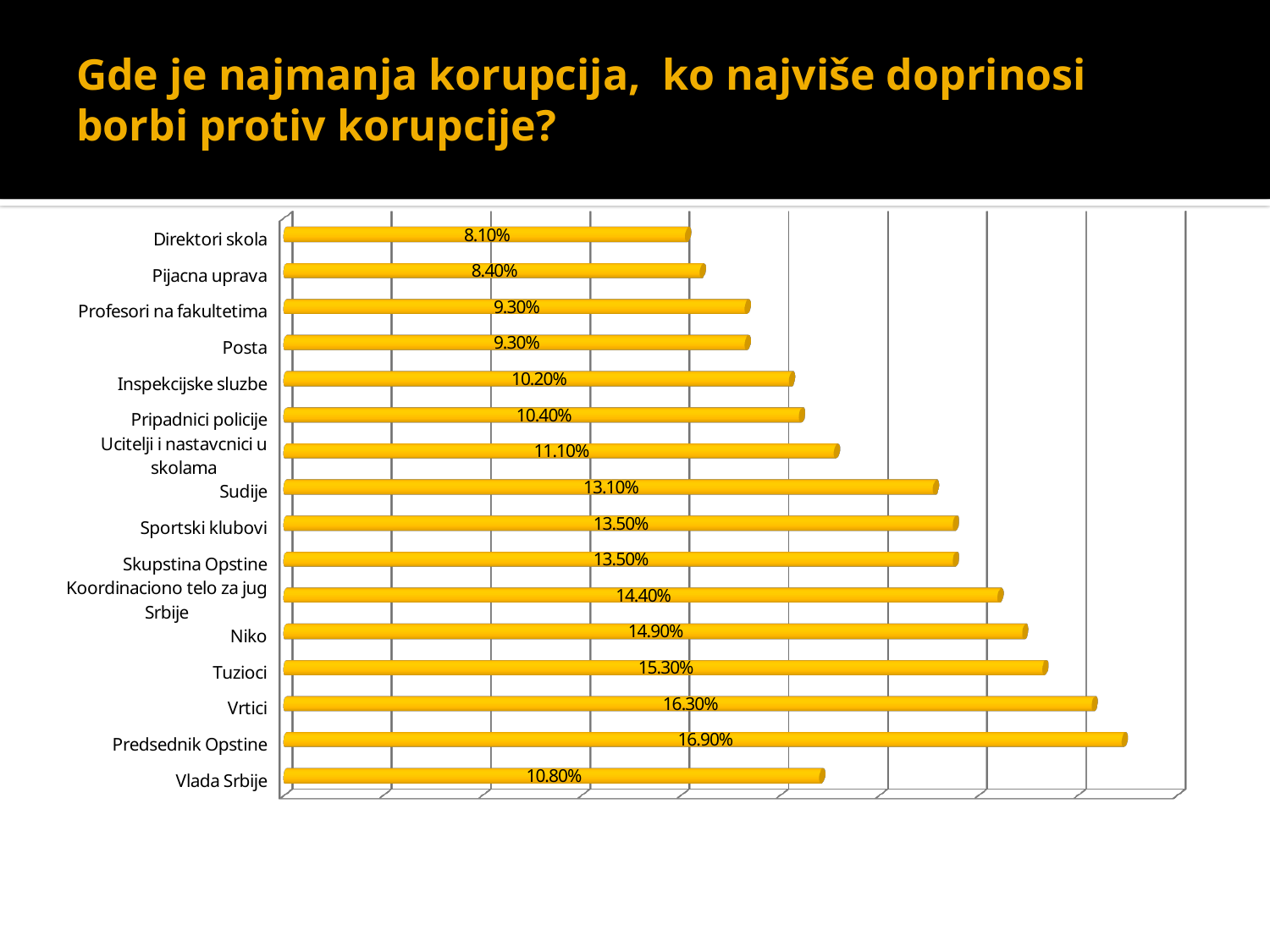
What is the difference between the values for Vrtici and Tuzioci? 1.00% What is the value for Sudije? 13.10% What is the value for Pripadnici policije? 10.40% What is the value for Vlada Srbije? 10.80% What is the value for Predsednik Opstine? 16.90% What is the title of the slide? Gde je najmanja korupcija, ko najviše doprinosi borbi protiv korupcije? What kind of chart is shown on the slide? Bar chart Which has a larger value, Niko or Koordinaciono telo za jug Srbije? Niko How many categories are shown in the chart? 16 Which category has the highest value? Predsednik Opstine What is the difference between the values for Predsednik Opstine and Direktori skola? 8.80% Which category has the lowest value? Direktori skola